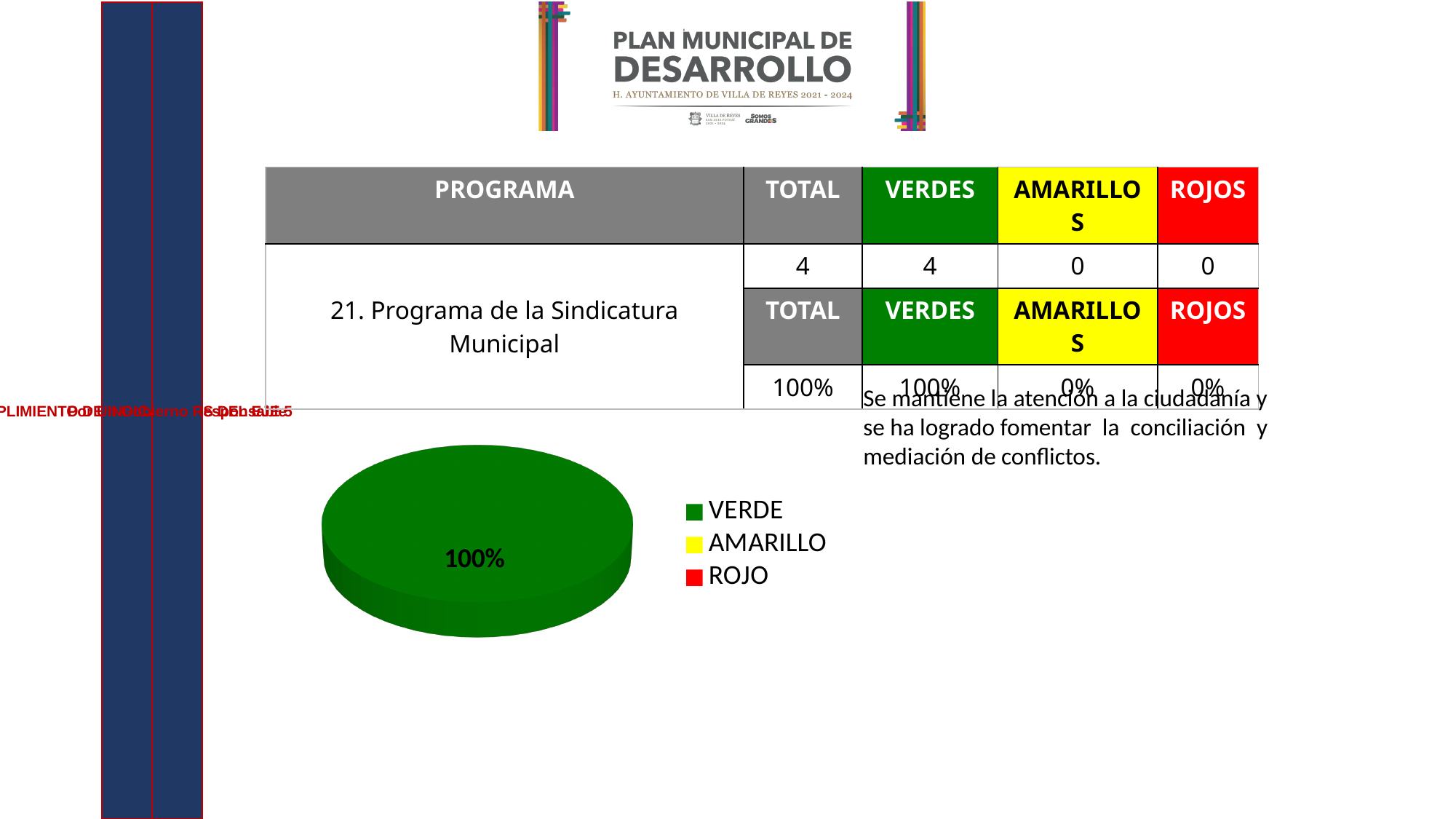
How many slices are visible in the pie chart? 1 What kind of chart is shown on the slide? pie chart Which is larger in the pie chart, VERDE or AMARILLO? VERDE Which category has the largest slice in the pie chart? VERDE What share of the pie chart does VERDE represent? 100% What value is printed on the pie chart's data label? 100% What colour is the VERDE slice in the pie chart? green How many entries does the pie chart's legend list? 3 Which is larger in the pie chart, VERDE or ROJO? VERDE Which legend entry is shown in red in the pie chart's legend? ROJO